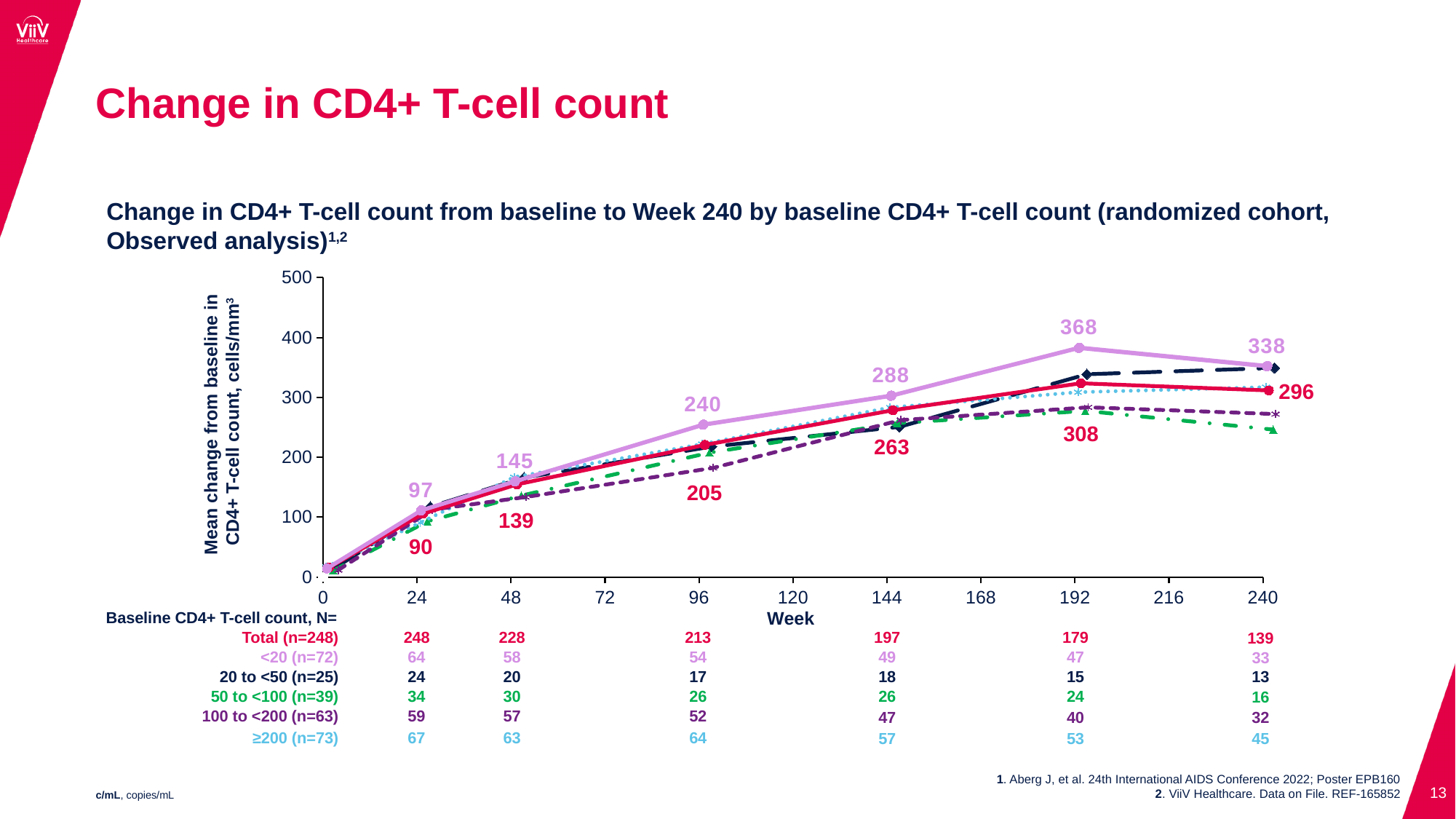
What is the difference between the <20 group's value at Week 192 and its value at Week 240? 30 At Week 240, which has the larger mean change from baseline: the <20 group or the Total group? <20 group At which week does the <20 group reach its highest labelled mean change from baseline? Week 192 What is the mean change from baseline for the Total group at Week 96? 205 What kind of chart is shown on the slide? Line chart At Week 144, how much higher is the <20 group's value than the Total group's value? 25 What is the mean change from baseline for the Total group at Week 240? 296 How many baseline CD4+ T-cell count groups (lines) are plotted on the chart? 6 What is the mean change from baseline for the <20 group at Week 48? 145 Does the Total group's mean change from baseline rise or fall between Week 0 and Week 192? Rise Is the value for the 50 to <100 group at Week 240 greater or less than 300? less What is the mean change from baseline for the <20 baseline CD4+ group at Week 192? 368